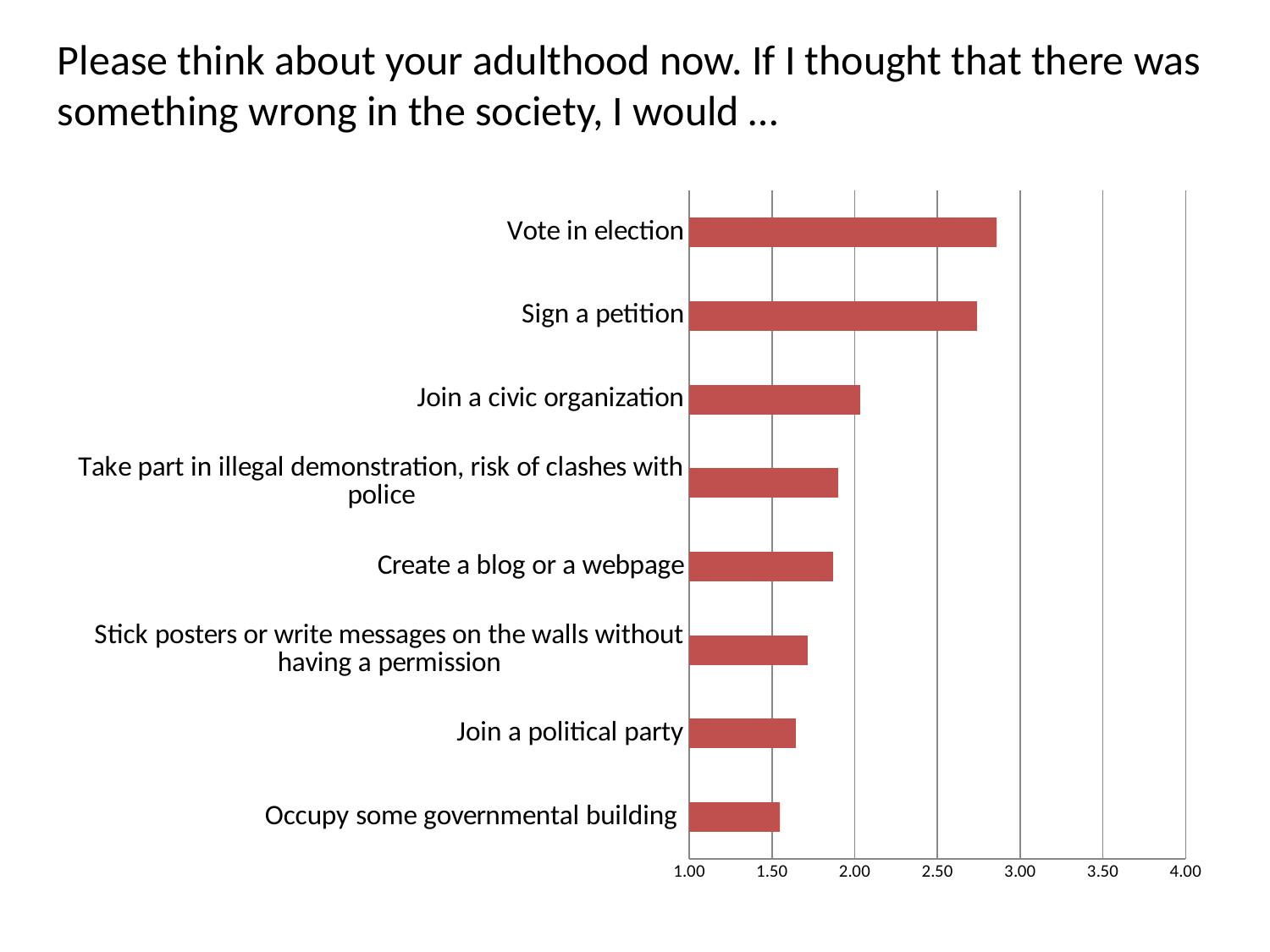
Is the value for Join a political party greater or less than 1.50? greater How many categories (bars) does the chart show? 8 What kind of chart is shown on the slide? Bar chart Which has a larger value, Vote in election or Join a civic organization? Vote in election Which category has the lowest value? Occupy some governmental building Is the value for Stick posters or write messages on the walls without having a permission greater or less than 2.00? less Which has a larger value, Sign a petition or Join a political party? Sign a petition Do the bar values increase or decrease going from the top category to the bottom category? decrease Is the value for Create a blog or a webpage greater or less than 2.00? less Which category has the highest value? Vote in election